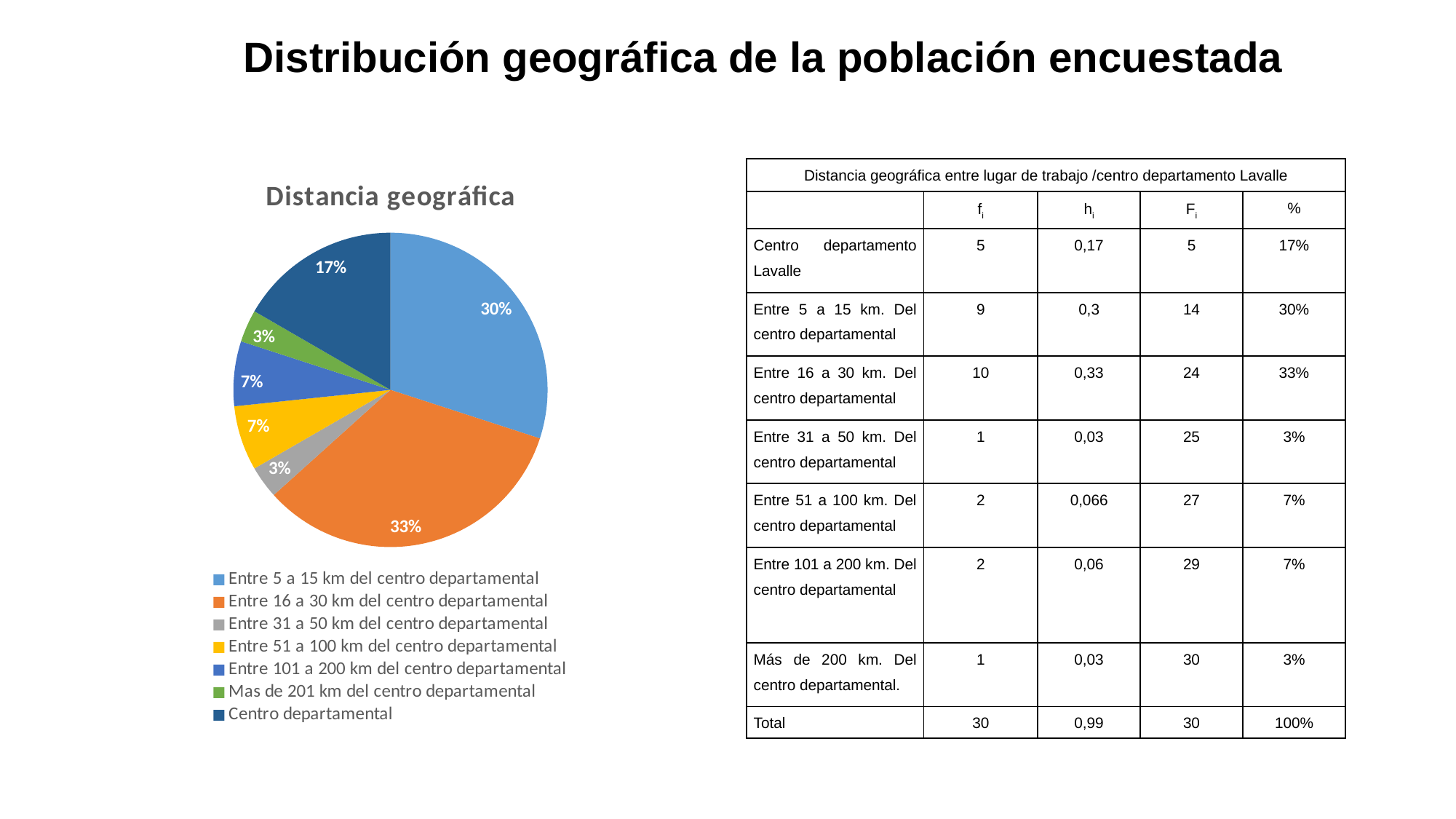
What is the value shown for 'Mas de 201 km del centro departamental'? 3% What is the title of the pie chart? Distancia geográfica Which is larger: the slice for 'Centro departamental' or the slice for 'Entre 5 a 15 km del centro departamental'? Entre 5 a 15 km del centro departamental What is the difference in percentage points between 'Entre 16 a 30 km del centro departamental' and 'Entre 5 a 15 km del centro departamental'? 3 Which colour represents 'Entre 16 a 30 km del centro departamental' in the legend? orange What is the value shown for 'Entre 5 a 15 km del centro departamental'? 30% What kind of chart is shown on the slide? pie chart What is the value shown for 'Centro departamental'? 17% What share of the pie does 'Entre 16 a 30 km del centro departamental' represent? 33% How many slices does the pie chart have? 7 What is the value shown for 'Entre 51 a 100 km del centro departamental'? 7% Which category has the largest slice of the pie? Entre 16 a 30 km del centro departamental